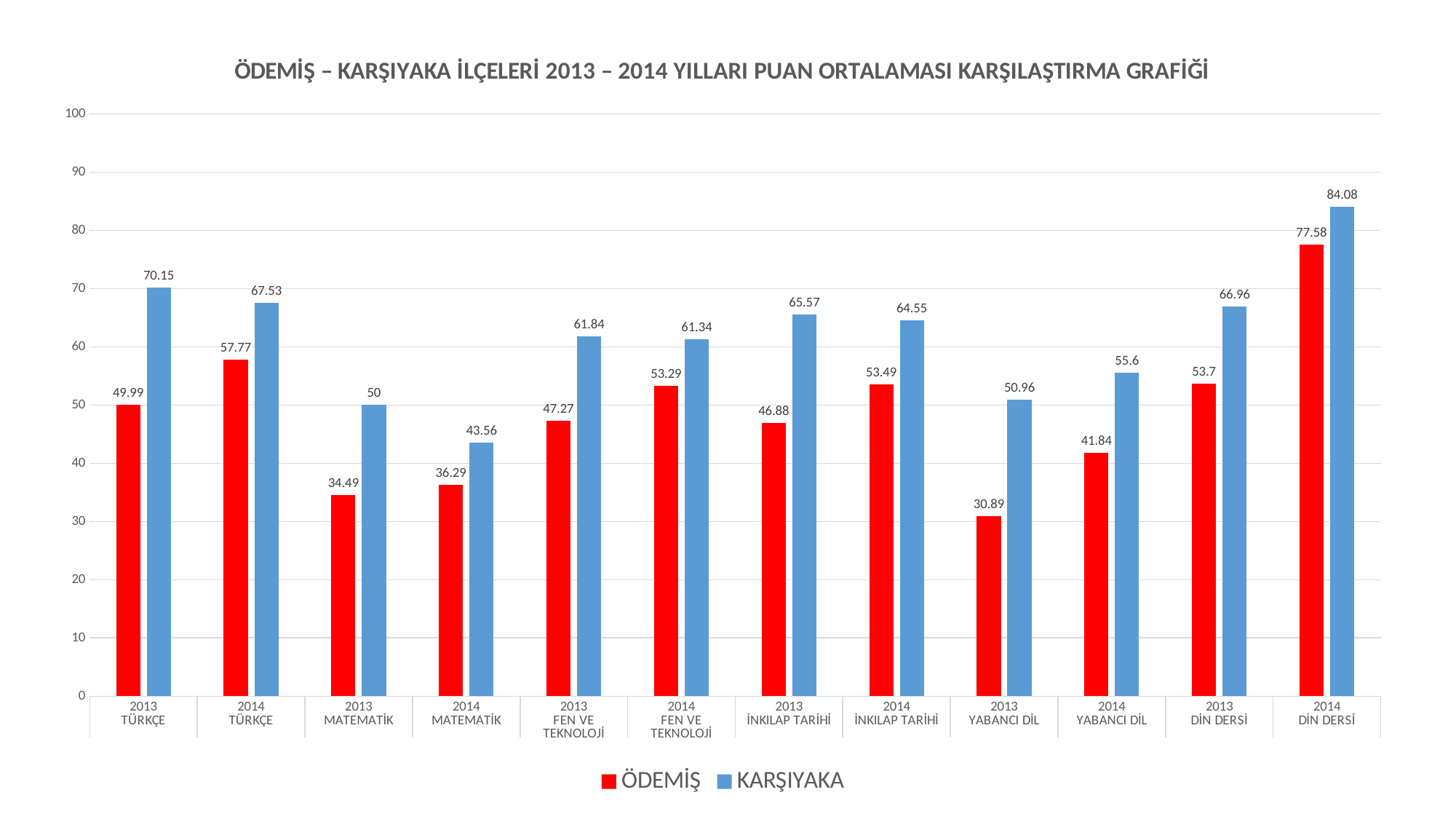
What kind of chart is shown on the slide? bar chart What is the difference between the KARŞIYAKA and ÖDEMİŞ values for 2013 TÜRKÇE? 20.16 What is the difference between the KARŞIYAKA and ÖDEMİŞ values for 2014 DİN DERSİ? 6.5 What is the ÖDEMİŞ value for 2013 DİN DERSİ? 53.7 Which category has the lowest ÖDEMİŞ value? 2013 YABANCI DİL How many categories are shown on the x axis? 12 For 2013 MATEMATİK, which series has the larger value, ÖDEMİŞ or KARŞIYAKA? KARŞIYAKA What is the ÖDEMİŞ value for 2013 TÜRKÇE? 49.99 Which category has the highest KARŞIYAKA value? 2014 DİN DERSİ How many series does the legend list? 2 What is the KARŞIYAKA value for 2014 MATEMATİK? 43.56 Is the ÖDEMİŞ value for 2014 YABANCI DİL greater or less than 50? less